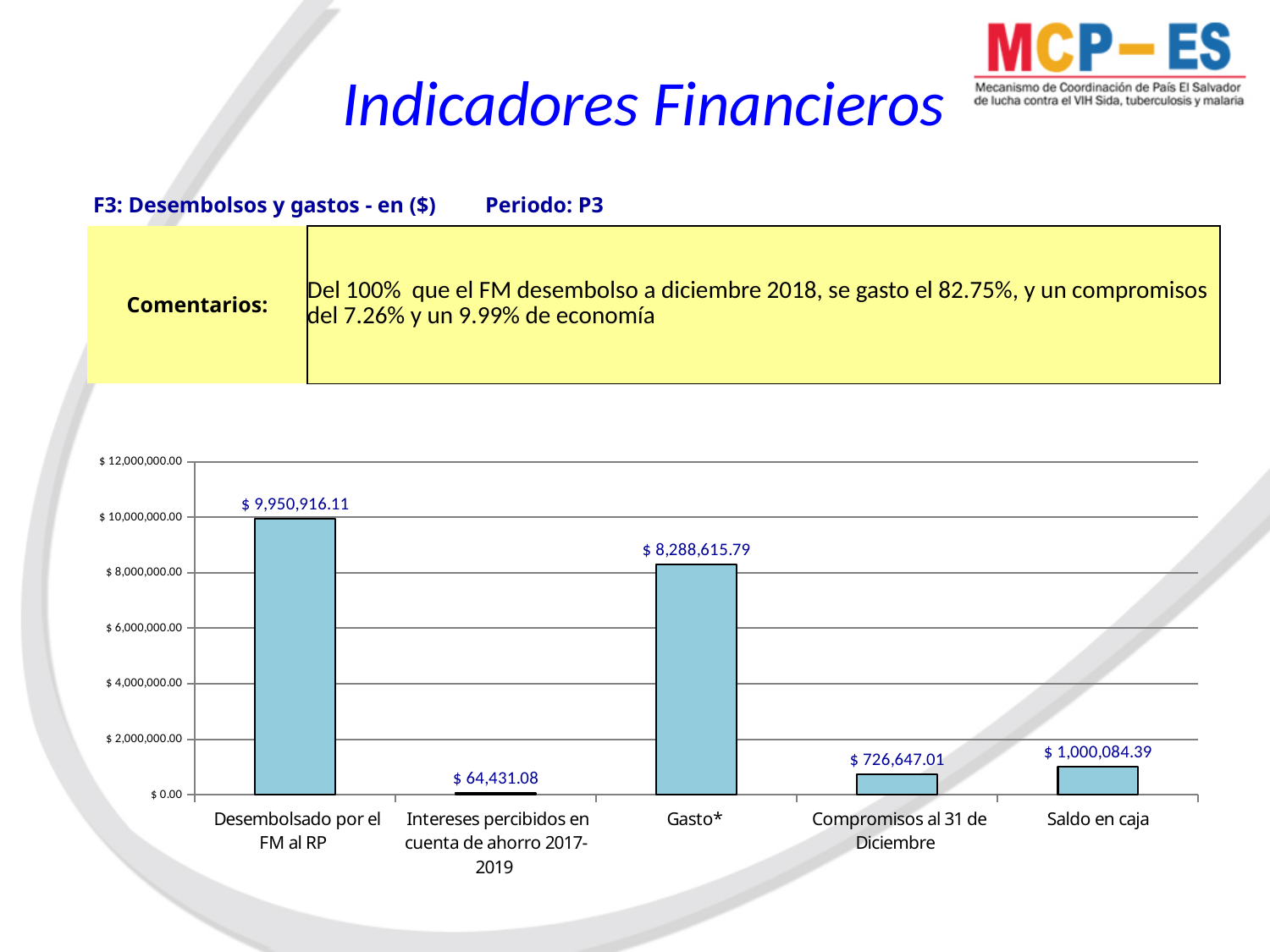
What is the value for Compromisos al 31 de Diciembre? $ 726,647.01 What is the value for Intereses percibidos en cuenta de ahorro 2017-2019? $ 64,431.08 Which is larger, Saldo en caja or Compromisos al 31 de Diciembre? Saldo en caja What is the difference between Saldo en caja and Compromisos al 31 de Diciembre? $ 273,437.38 Which category has the highest value? Desembolsado por el FM al RP What is the value for Desembolsado por el FM al RP? $ 9,950,916.11 Which category has the lowest value? Intereses percibidos en cuenta de ahorro 2017-2019 What is the value for Saldo en caja? $ 1,000,084.39 What is the value for Gasto*? $ 8,288,615.79 What is the difference between Desembolsado por el FM al RP and Gasto*? $ 1,662,300.32 What kind of chart is shown on the slide? Bar chart How many categories are shown on the x axis? 5